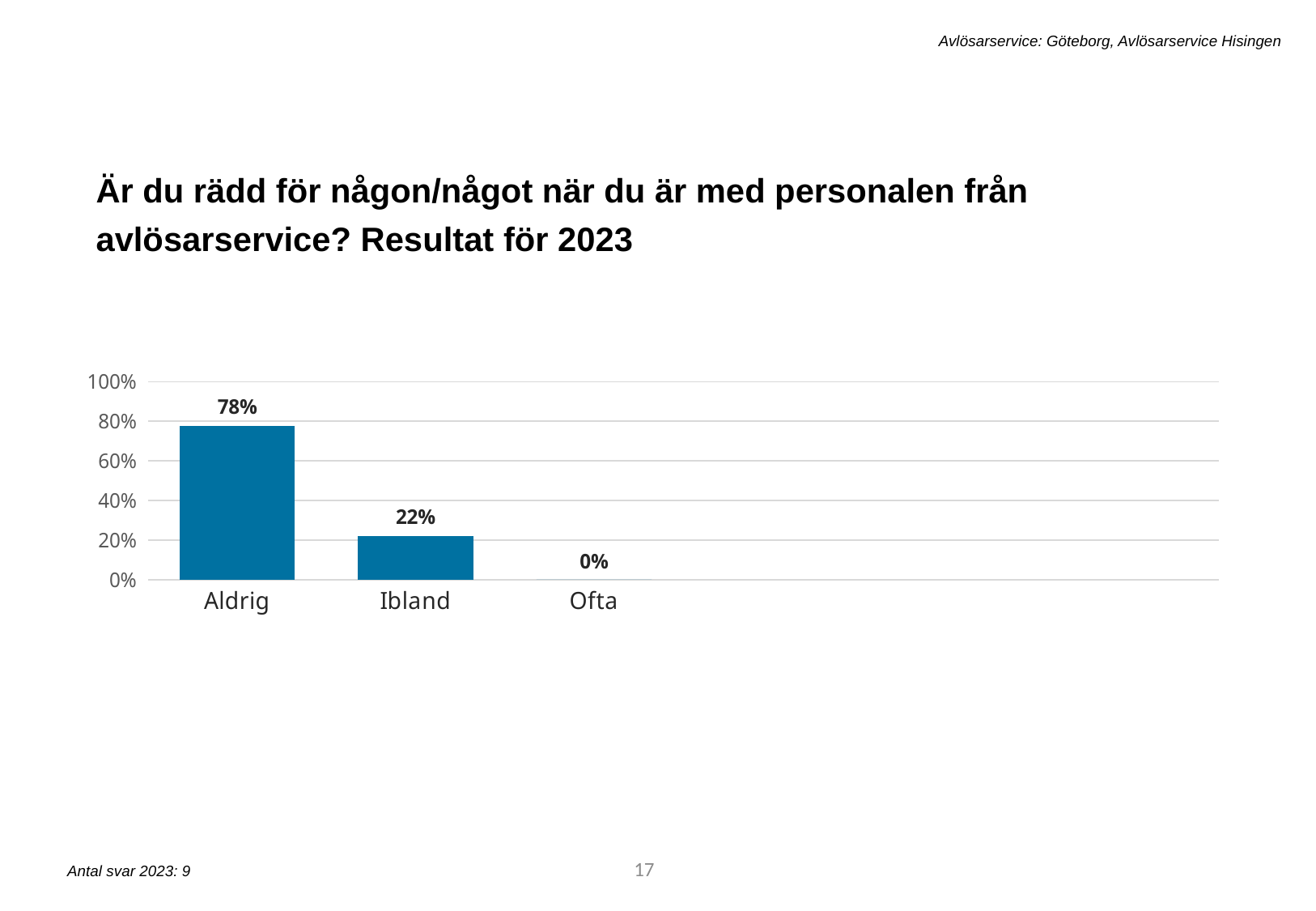
What is the difference between the values for Aldrig and Ibland? 56% What is the value for Ofta? 0% Which category has the lowest value? Ofta Is the value for Aldrig greater or less than 60%? greater What is the highest value shown on the y axis? 100% What is the value for Aldrig? 78% How many categories are shown on the x axis? 3 Which is larger, the value for Ibland or the value for Ofta? Ibland What kind of chart is shown on the slide? Bar chart Do the values rise or fall from left to right along the x axis? Fall Which category has the highest value? Aldrig What is the value for Ibland? 22%